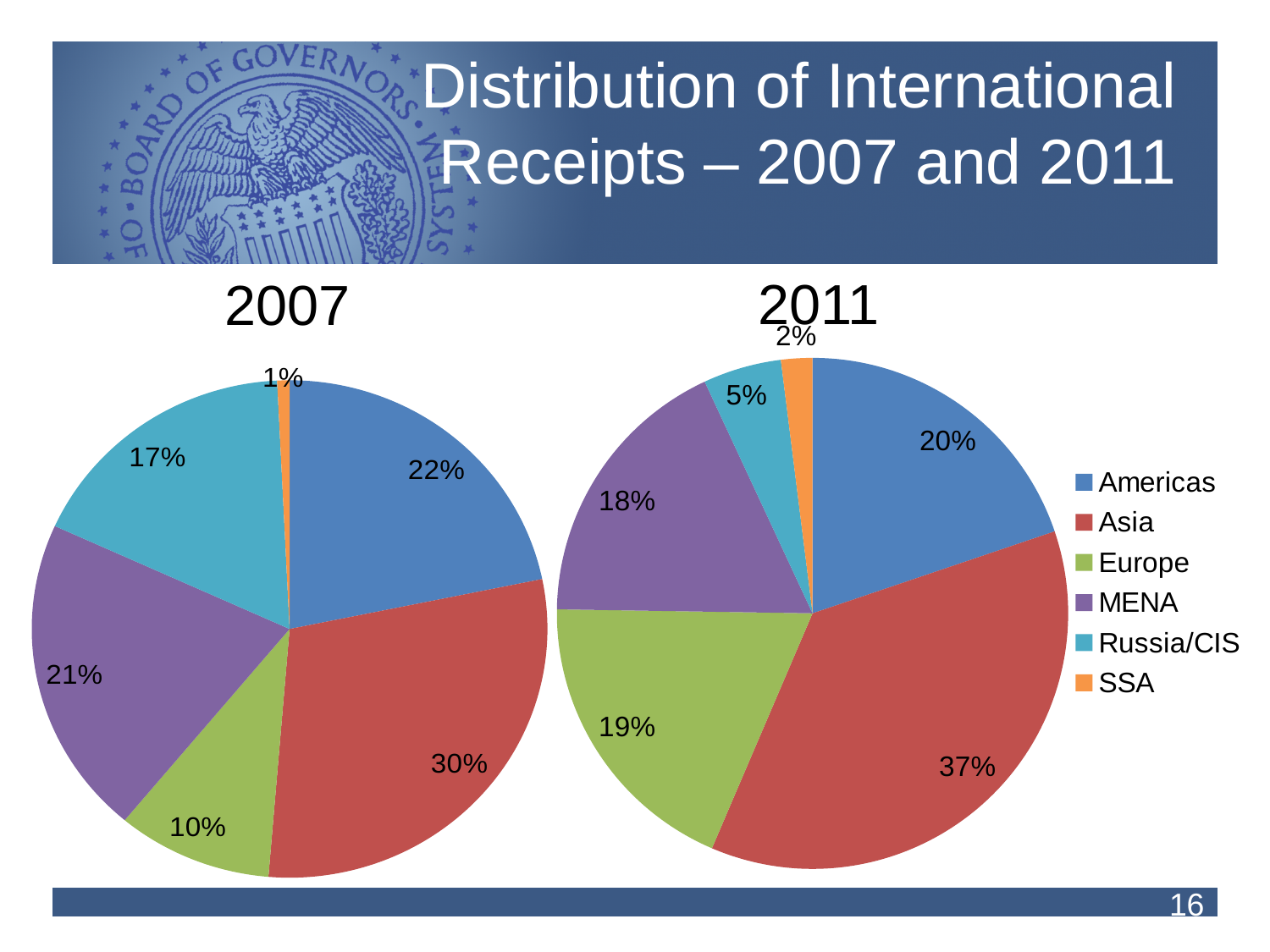
What is the difference between Asia's share in the 2011 pie chart and Asia's share in the 2007 pie chart? 7 percentage points In the 2011 pie chart, which region has the largest share? Asia In the 2011 pie chart, what is the value for MENA? 18% In the 2007 pie chart, which is larger: the share for Americas or the share for MENA? Americas In the 2011 pie chart, what share of international receipts came from Europe? 19% In the 2007 pie chart, what share of international receipts came from Asia? 30% How many regions does the legend list? 6 In the 2007 pie chart, which region has the smallest share? SSA In the 2011 pie chart, what is the difference between the Americas share and the Russia/CIS share? 15 percentage points In the 2007 pie chart, what is the value for Russia/CIS? 17% Which colour represents Europe in the pie charts? Green What type of chart is used for the 2007 and 2011 data? Pie chart